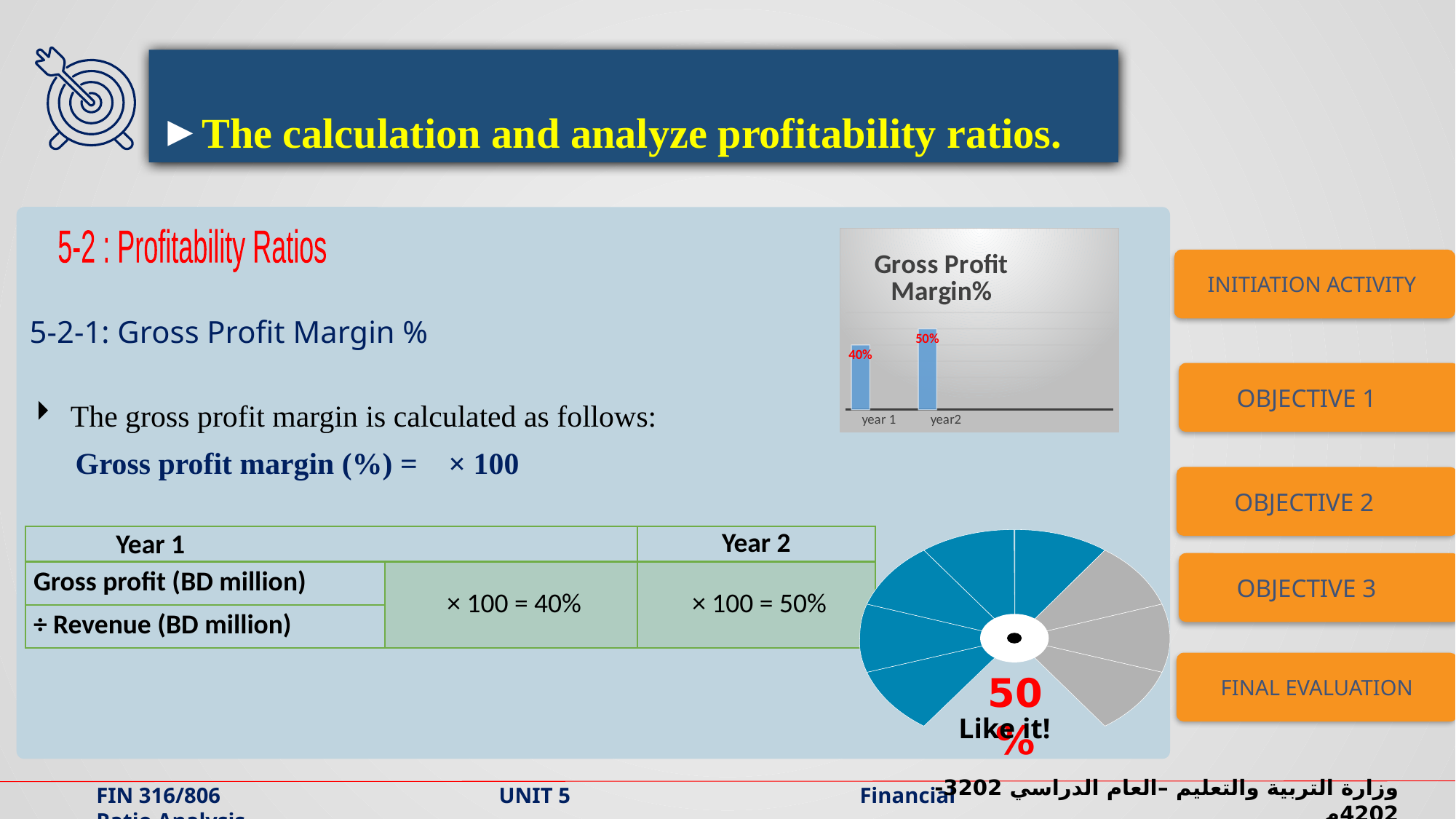
In the Gross Profit Margin% chart, which year has the lower gross profit margin? year 1 In the Gross Profit Margin% chart, what is the difference between the year2 and year 1 values? 10% In the Gross Profit Margin% chart, what is the value for year 1? 40% How many bars are plotted in the Gross Profit Margin% chart? 2 What type of chart is the Gross Profit Margin% chart? bar chart What is the title of the bar chart on the slide? Gross Profit Margin% In the Gross Profit Margin% chart, is the value for year 1 larger or smaller than the value for year2? smaller In the Gross Profit Margin% chart, do the values rise or fall from year 1 to year2? rise What colour are the bars in the Gross Profit Margin% chart? blue In the Gross Profit Margin% chart, which year has the higher gross profit margin? year2 In the Gross Profit Margin% chart, what is the value for year2? 50%